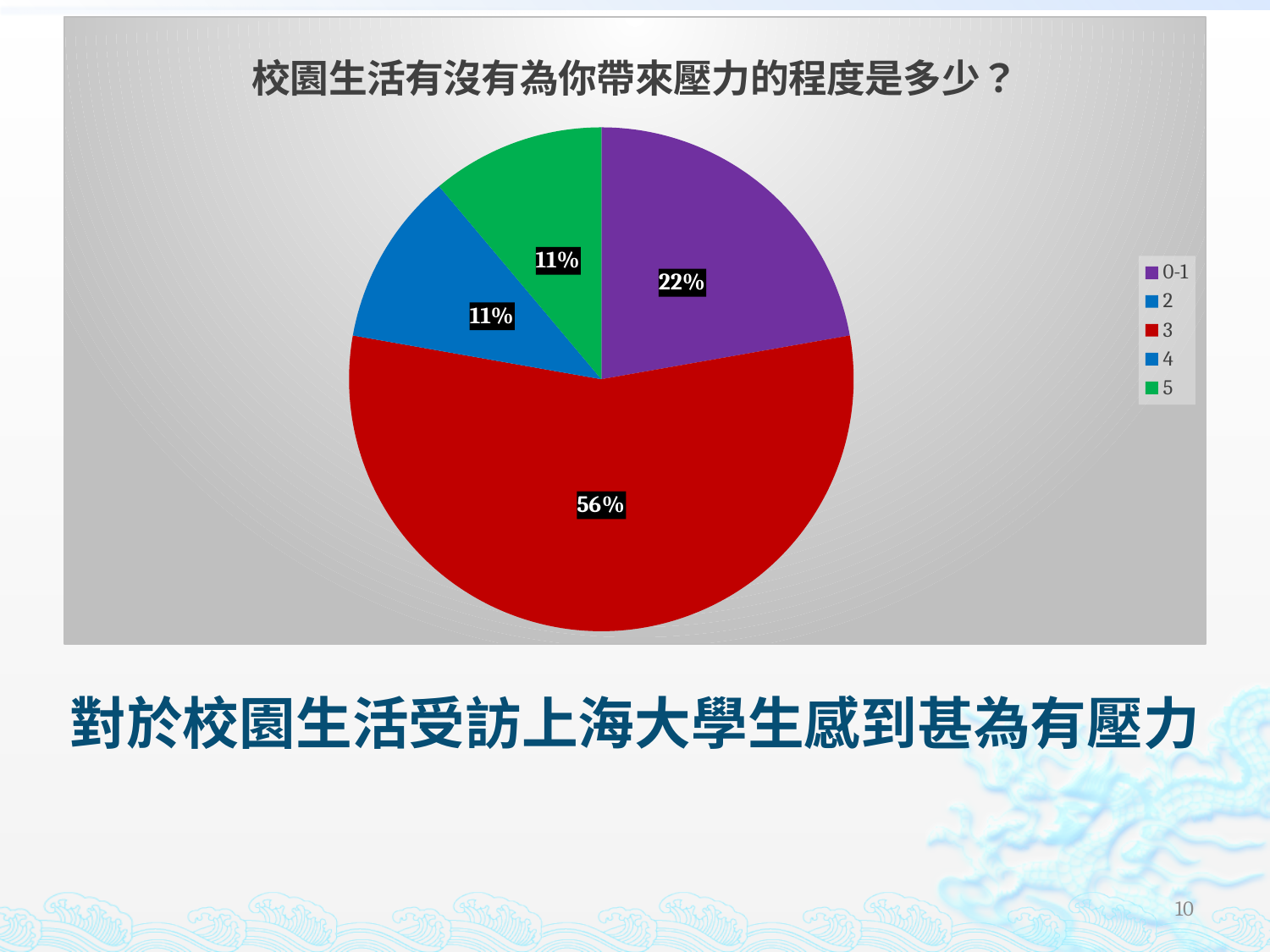
How many slices are visible in the pie? 4 How many entries does the legend list? 5 What is the difference in percentage points between the slice for category 3 and the slice for category 0-1? 34 What type of chart is shown on the slide? pie chart What percentage of the pie is the slice for category 0-1? 22% Which category has the largest slice of the pie? 3 What is the title of the chart? 校園生活有沒有為你帶來壓力的程度是多少？ Is the slice for category 3 more or less than half of the pie? more What percentage of the pie is the slice for category 3? 56% What colour is the slice for category 3? red What percentage of the pie is the slice for category 5? 11% Which slice is larger, the one for category 0-1 or the one for category 5? 0-1